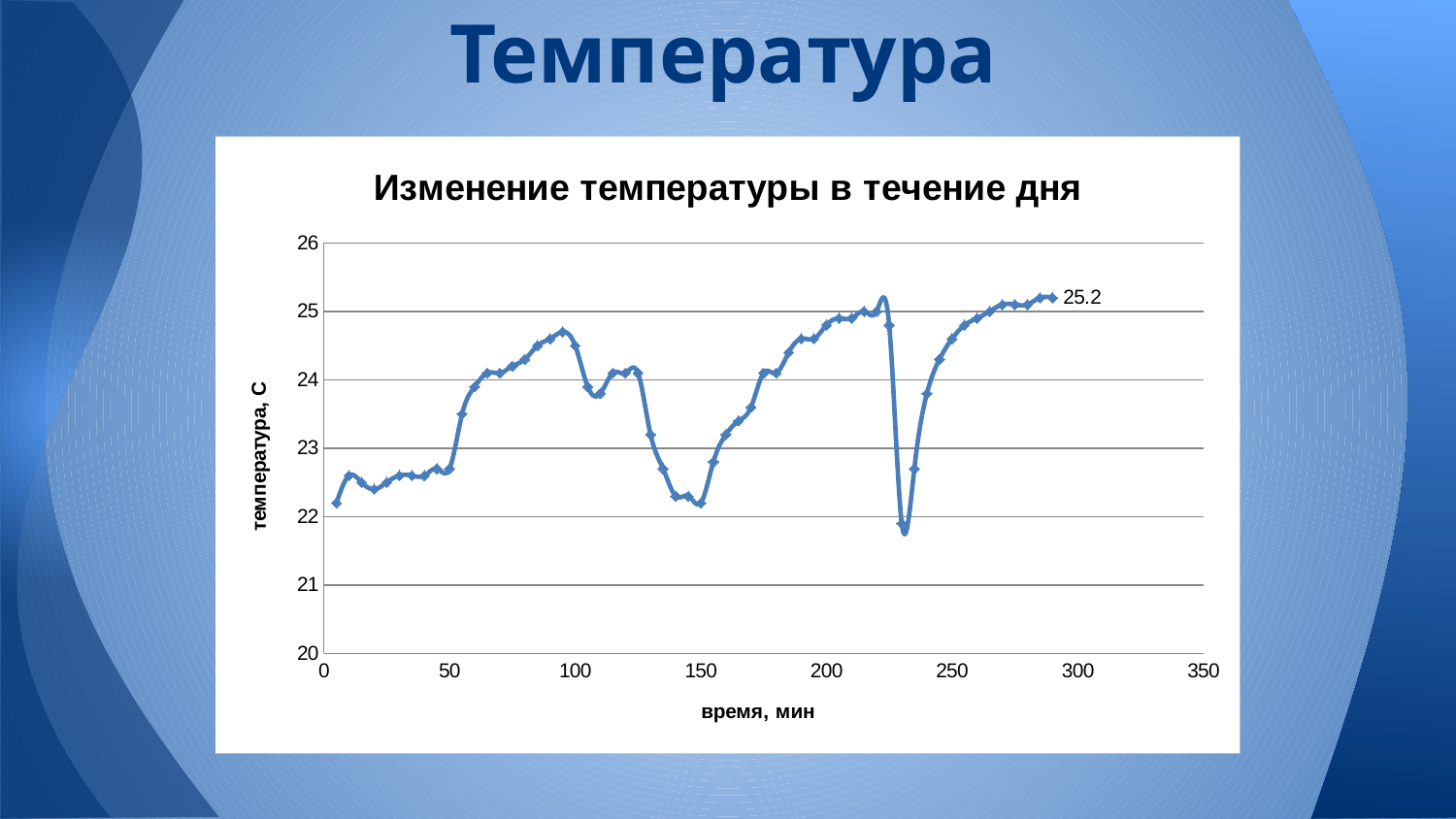
What is the label of the x axis? время, мин Is the lowest point of the line, near 230 minutes, greater or less than 22? less What is the value shown by the data label at the end of the line? 25.2 Is the temperature at 100 minutes greater or less than 24? greater Is the temperature at 50 minutes greater or less than 23? less Overall, does the temperature rise or fall from the start of the chart to the end? rise What is the title of the chart? Изменение температуры в течение дня What kind of chart is shown on the slide? line chart Which is larger: the temperature at 100 minutes or the temperature at 150 minutes? 100 minutes